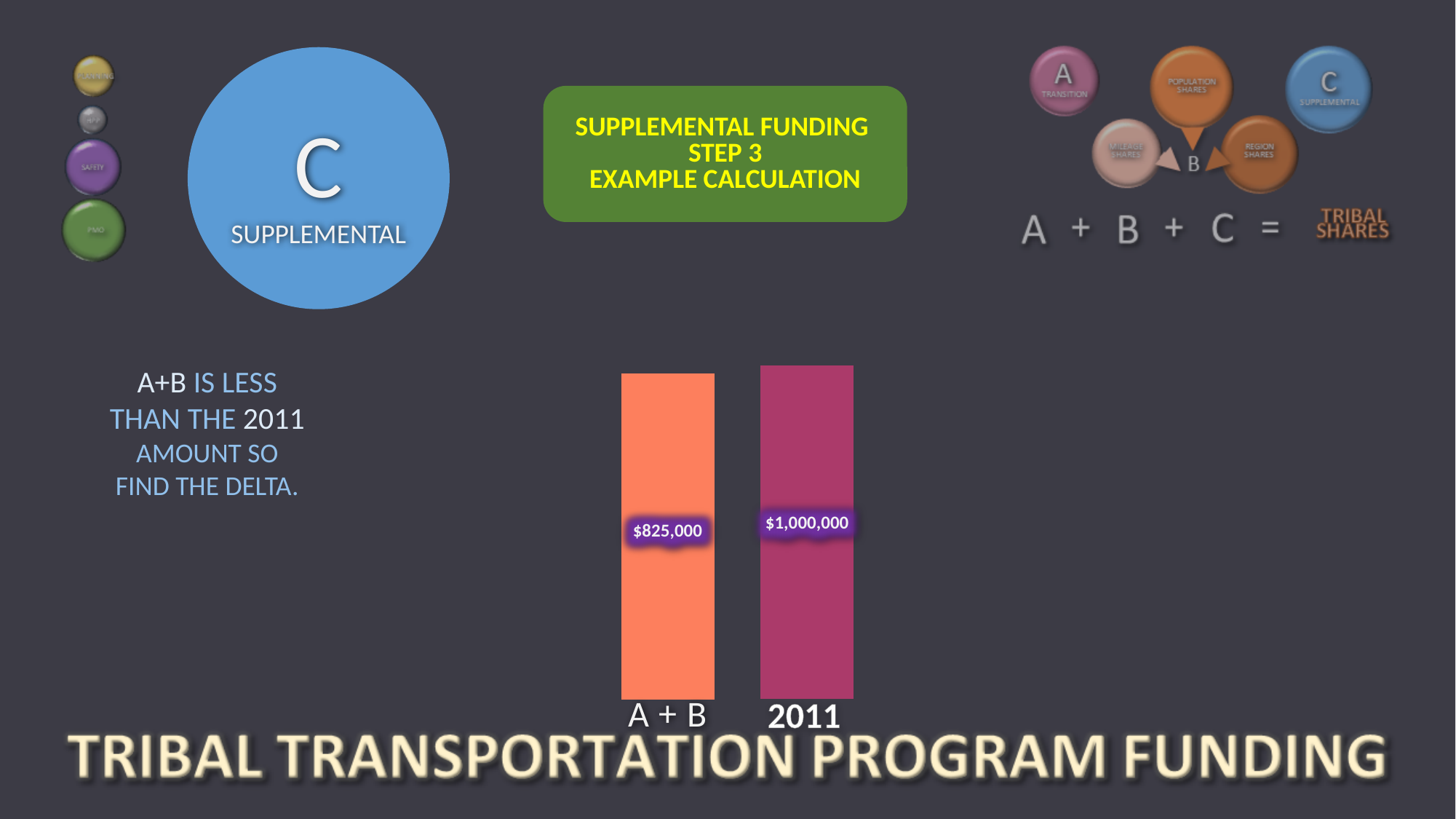
What colour is the A + B bar? orange Which bar is taller, A + B or 2011? 2011 How many bars are shown in the chart? 2 What is the difference between the 2011 value and the A + B value? $175,000 Which category has the highest value? 2011 What colour is the 2011 bar? magenta What is the value of the 2011 bar? $1,000,000 What kind of chart is shown on the slide? bar chart What is the value of the A + B bar? $825,000 Which category has the lowest value? A + B